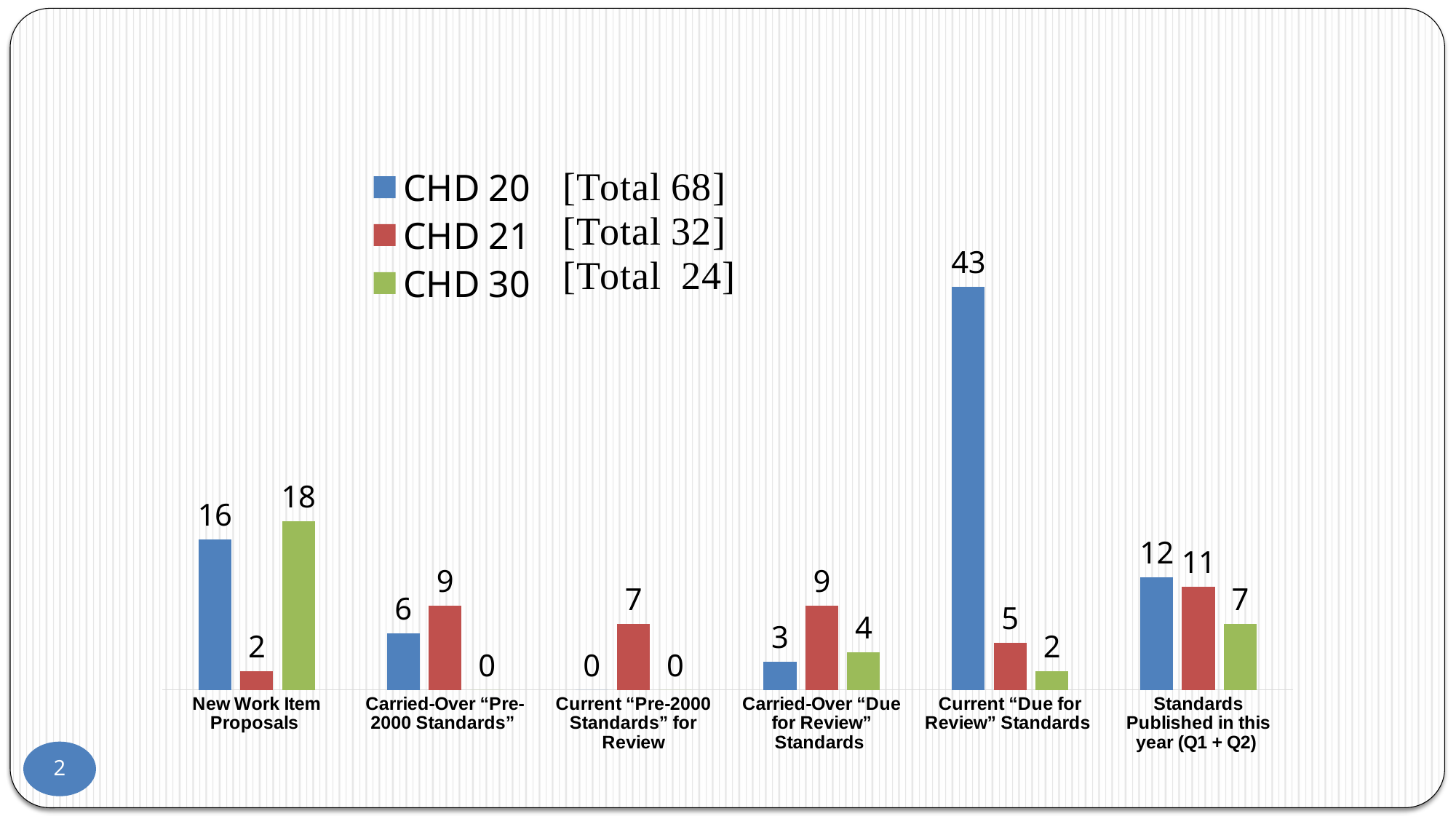
Which category has the highest CHD 20 value? Current "Due for Review" Standards What is the difference between the CHD 20 and CHD 21 values for Current "Due for Review" Standards? 38 Which is larger for Carried-Over "Pre-2000 Standards": CHD 20 or CHD 21? CHD 21 What kind of chart is shown on the slide? Bar chart What is the CHD 20 value for Current "Due for Review" Standards? 43 How many categories are shown on the x axis? 6 What is the CHD 21 value for Standards Published in this year (Q1 + Q2)? 11 What is the CHD 21 value for Current "Pre-2000 Standards" for Review? 7 How many series does the legend list? 3 Which colour represents CHD 30 in the legend? Green Which series has the lowest value for New Work Item Proposals? CHD 21 What is the CHD 30 value for New Work Item Proposals? 18